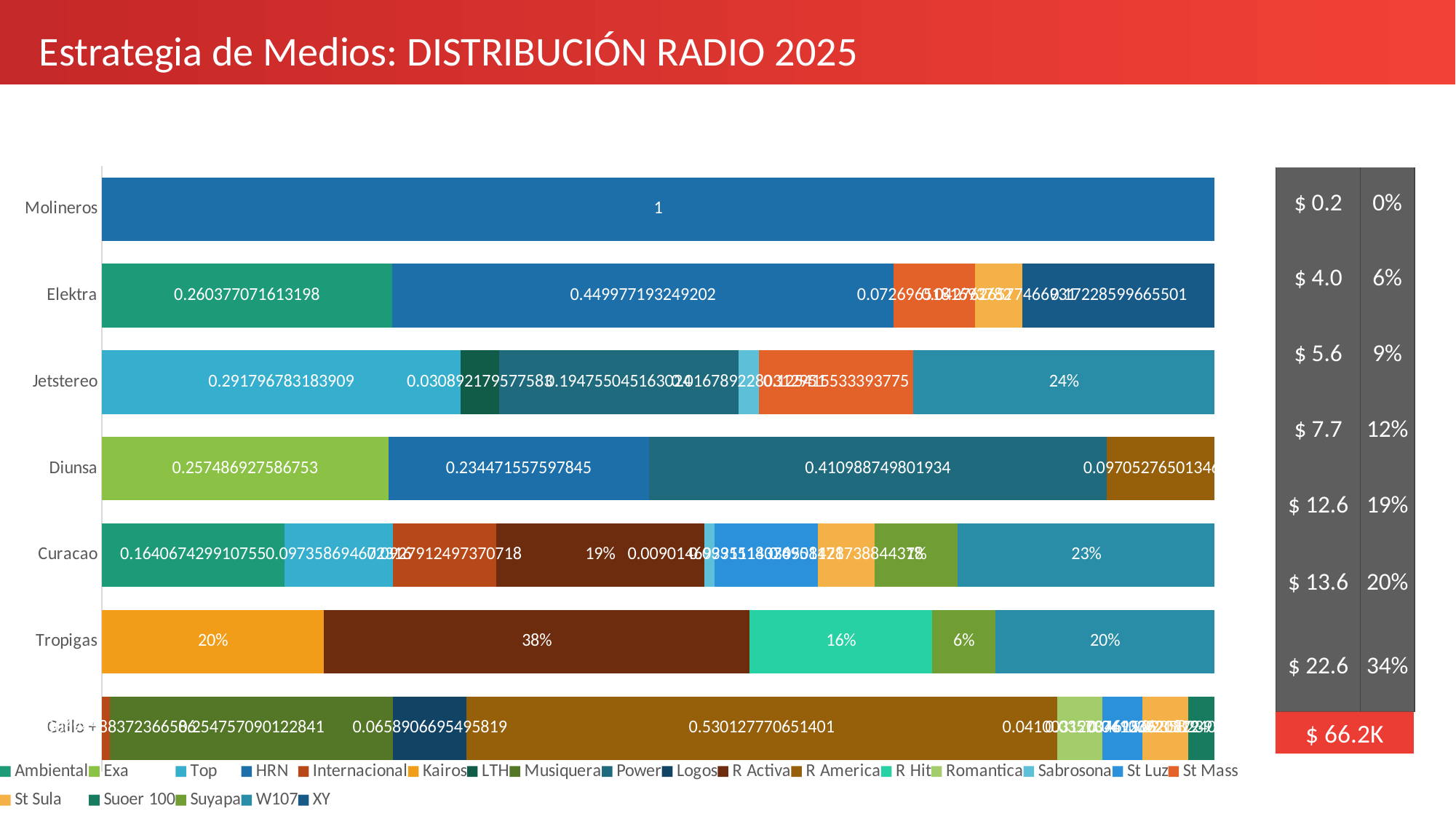
What is the labelled share of R Activa in the Tropigas bar? 38% What is the labelled share of W107 in the Jetstereo bar? 24% What is the labelled share of R Hit in the Tropigas bar? 16% What value is labelled on the Molineros bar? 1 Which series has the largest segment in the Tropigas bar? R Activa How many categories (retailers) are plotted on the y axis of the chart? 7 What is the title of the slide containing the chart? Estrategia de Medios: DISTRIBUCIÓN RADIO 2025 What kind of chart is shown on the slide? Stacked bar chart In the Tropigas bar, how much larger is the R Activa share than the Kairos share? 18 percentage points What is the labelled share of Kairos in the Tropigas bar? 20% How many series does the chart legend list? 22 In the Tropigas bar, which is larger: the R Hit segment or the Suyapa segment? R Hit